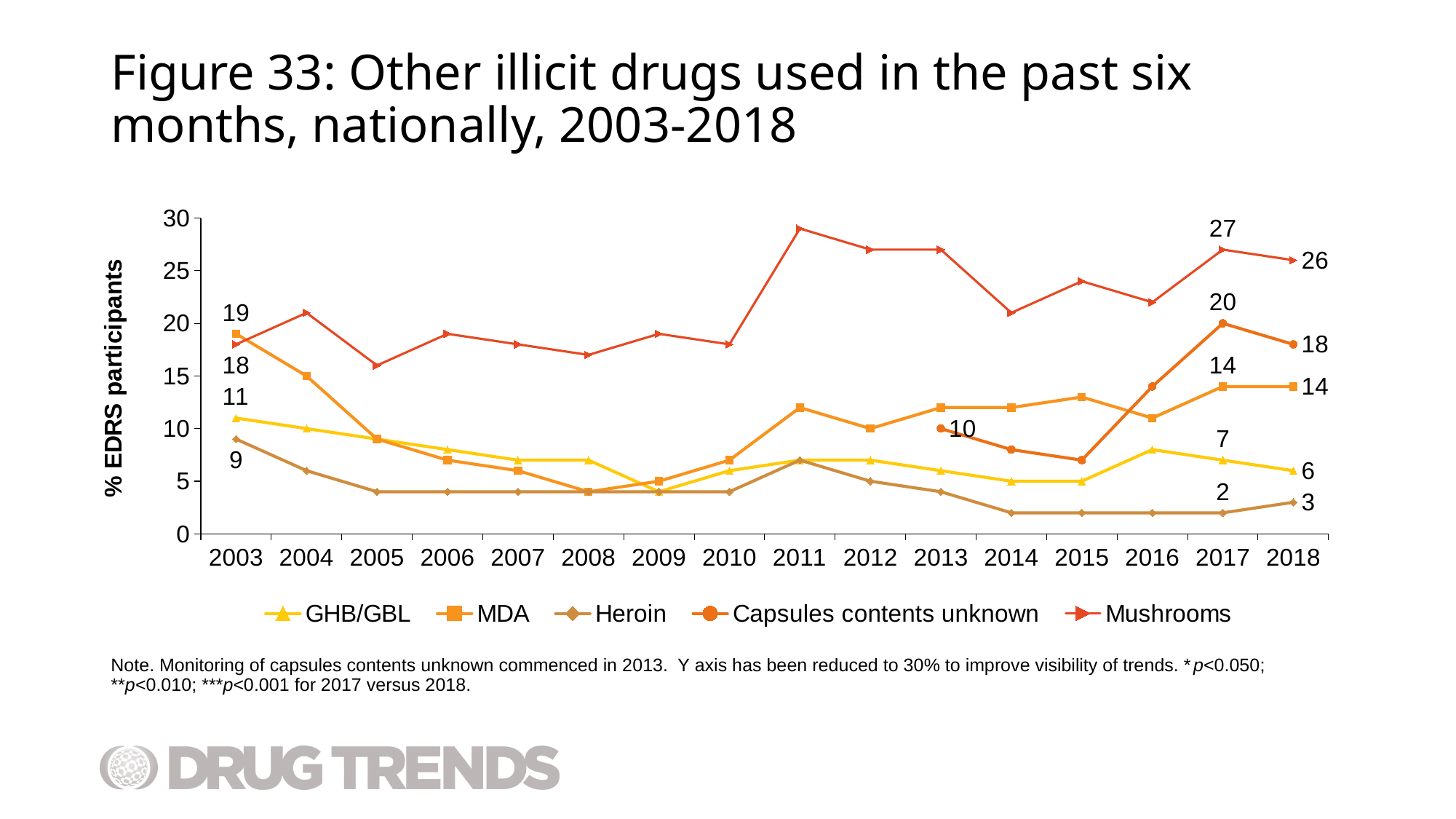
What is the value for Mushrooms in 2018? 26 Which series has the highest value in 2018? Mushrooms How many years are shown on the x axis? 16 What is the difference between the Mushrooms values for 2017 and 2018? 1 Which year has the larger value for Capsules contents unknown, 2017 or 2018? 2017 What is the label on the y axis? % EDRS participants Is the value for Mushrooms in 2011 greater or less than 25? greater What kind of chart is shown on the slide? line chart What is the value for MDA in 2003? 19 What is the value for Capsules contents unknown in 2013? 10 Which series has the lowest value in 2017? Heroin How many series does the legend list? 5